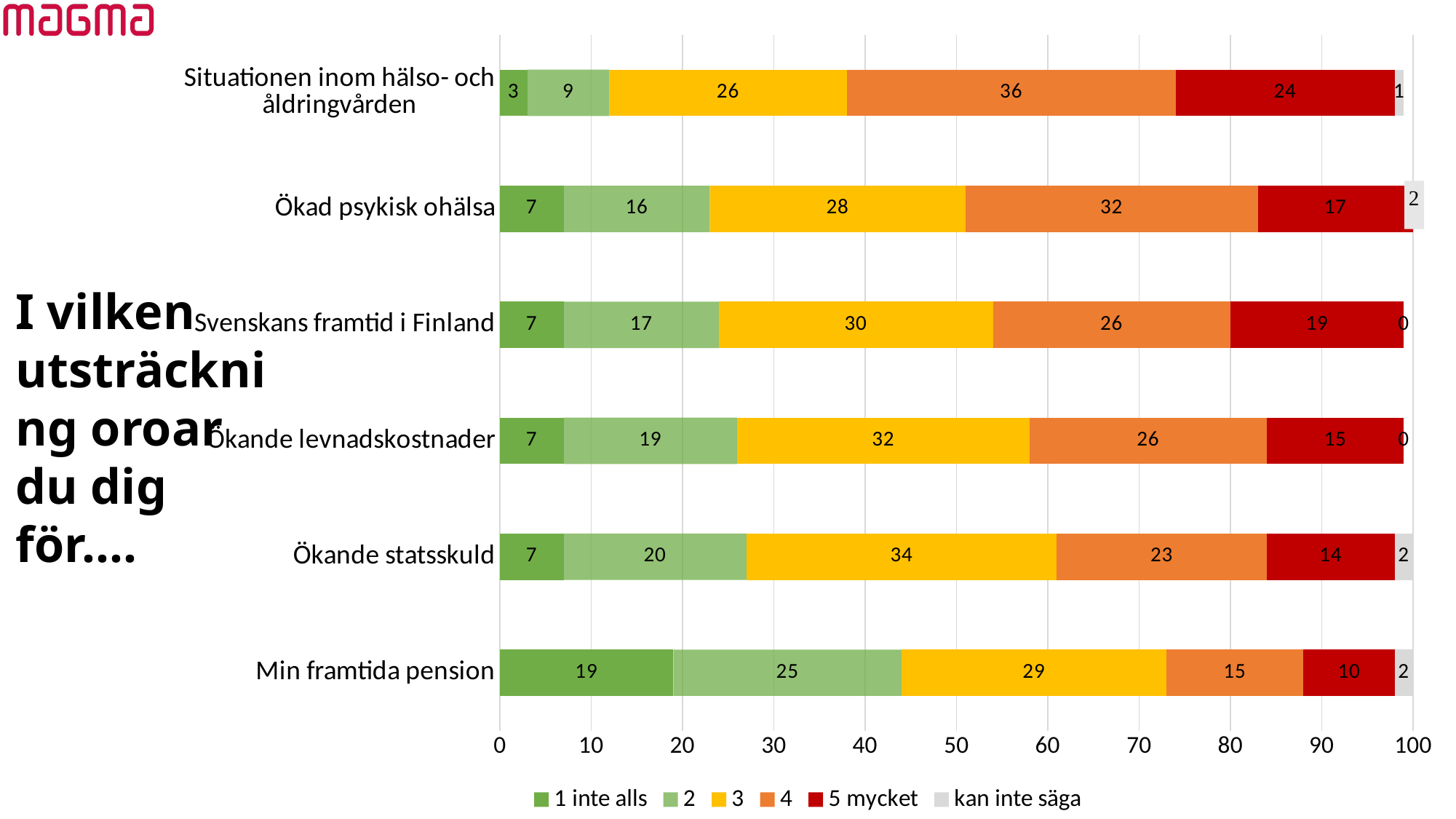
What is the value of the "2" segment for "Ökad psykisk ohälsa"? 16 Which category has the highest "5 mycket" value? Situationen inom hälso- och åldringvården How many series does the legend list? 6 What is the value of the "5 mycket" segment for "Situationen inom hälso- och åldringvården"? 24 What is the value of the "1 inte alls" segment for "Min framtida pension"? 19 What is the difference between the "4" value for "Situationen inom hälso- och åldringvården" and the "4" value for "Min framtida pension"? 21 Which category has the lowest "5 mycket" value? Min framtida pension What is the first entry in the chart's legend? 1 inte alls What kind of chart is shown on the slide? bar chart Which category has the highest "1 inte alls" value? Min framtida pension How many categories are plotted on the chart? 6 Which has the larger "3" value: "Ökande statsskuld" or "Ökande levnadskostnader"? Ökande statsskuld